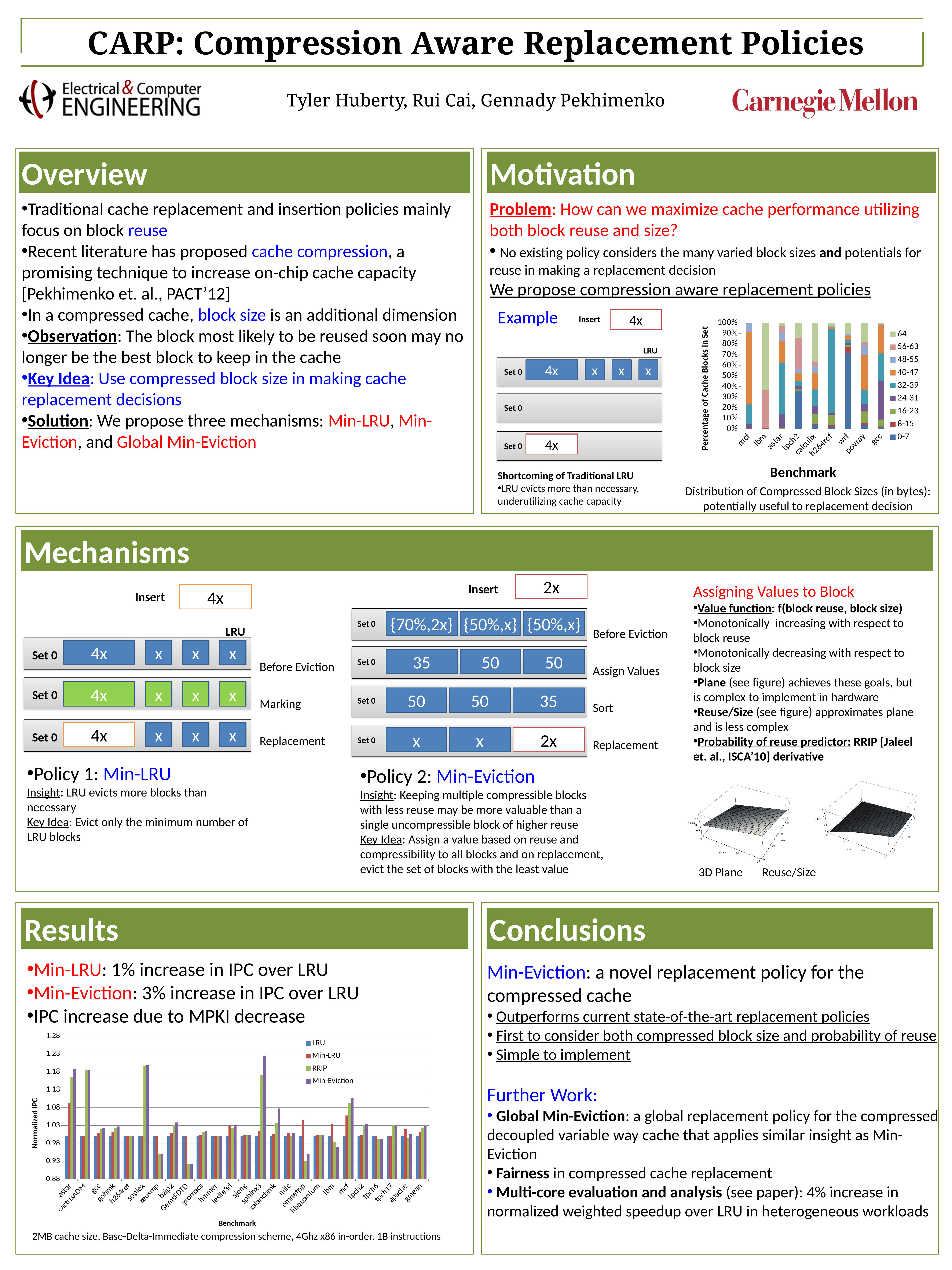
In the Results chart (Normalized IPC), which series has the highest value for sphinx3? Min-Eviction In the Results chart (Normalized IPC), is the Min-Eviction value for sphinx3 greater or less than 1.18? greater How many benchmarks are shown on the x axis of the Results chart (Normalized IPC)? 25 In the Results chart (Normalized IPC), which benchmark has the highest Min-Eviction value? sphinx3 In the Motivation chart (Distribution of Compressed Block Sizes), is the 0-7 segment for wrf greater or less than 50%? greater In the Results chart (Normalized IPC), is the RRIP value for soplex greater or less than 1.13? greater How many series does the legend of the Results chart (Normalized IPC) list? 4 How many benchmarks are shown on the x axis of the Motivation chart (Distribution of Compressed Block Sizes)? 9 In the Results chart (Normalized IPC), which is larger for astar: the LRU value or the Min-Eviction value? Min-Eviction How many series does the legend of the Motivation chart (Distribution of Compressed Block Sizes) list? 9 What kind of chart is the Normalized IPC chart in the Results section? bar chart What is the y-axis label of the Results chart? Normalized IPC